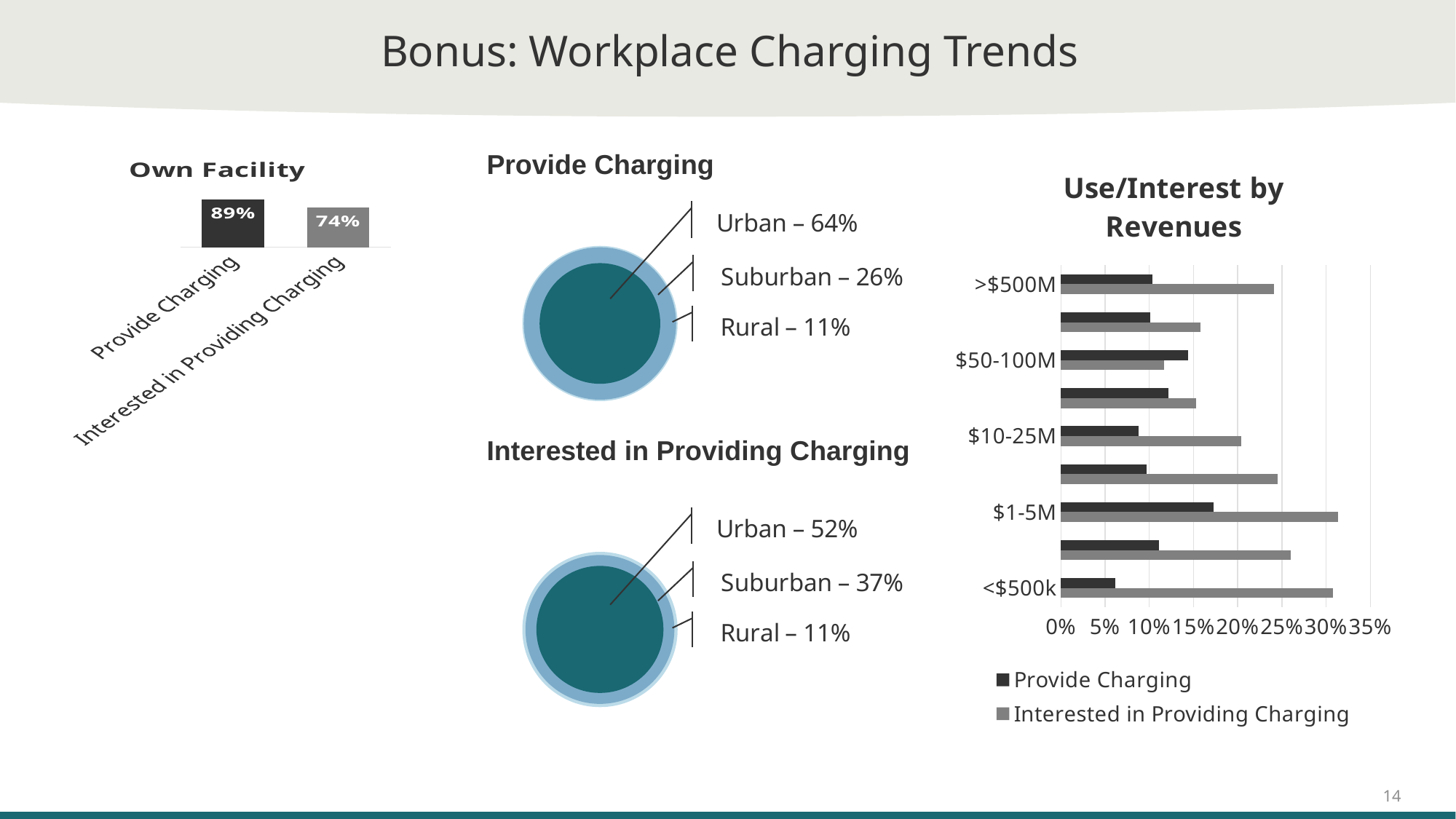
In the Use/Interest by Revenues chart, is the Provide Charging value for <$500k greater or less than 10%? less In the Own Facility chart, which is larger: Provide Charging or Interested in Providing Charging? Provide Charging In the Own Facility chart, what is the value for Provide Charging? 89% How many categories does the Interested in Providing Charging pie chart show? 3 In the Own Facility chart, what is the difference between Provide Charging and Interested in Providing Charging? 15% In the Provide Charging pie chart, what share is Suburban? 26% In the Provide Charging pie chart, which category has the largest share? Urban In the Own Facility chart, what is the value for Interested in Providing Charging? 74% How many series does the legend of the Use/Interest by Revenues chart list? 2 In the Interested in Providing Charging pie chart, what share is Urban? 52% In the Use/Interest by Revenues chart, which revenue category has the lowest Provide Charging value? <$500k In the Interested in Providing Charging pie chart, which category has the smallest share? Rural